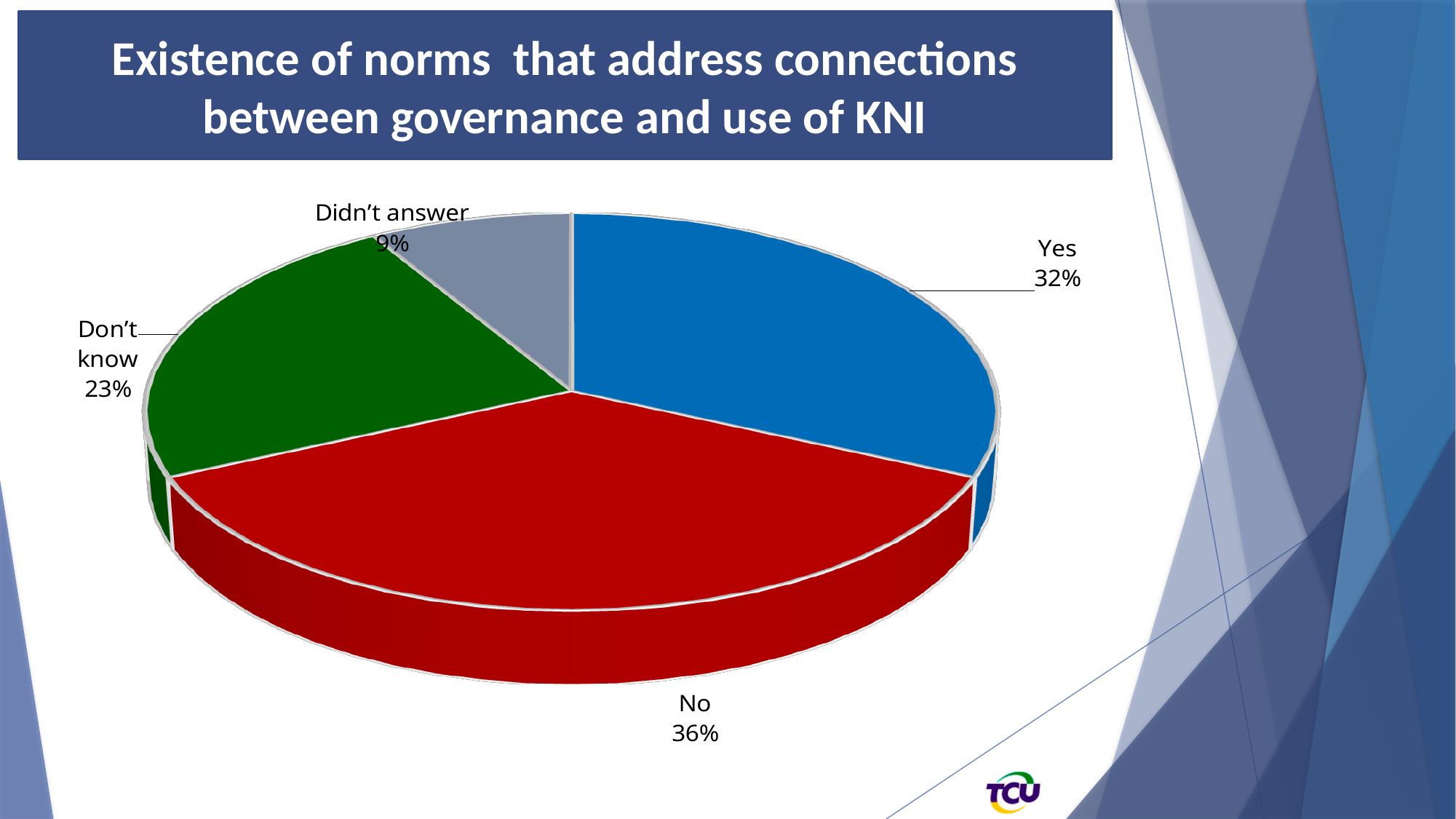
What kind of chart is shown on the slide? Pie chart How many slices does the pie chart have? 4 What is the combined share of "Yes" and "No" responses? 68% Which response has the largest share of the pie? No What percentage of respondents answered "No"? 36% Which is larger, the share for "Don't know" or the share for "Didn't answer"? Don't know What share of the pie is labelled "Don't know"? 23% What percentage is shown for "Didn't answer"? 9% What percentage of respondents answered "Yes"? 32% What is the difference in percentage points between "No" and "Yes"? 4 What colour is the "No" slice of the pie? Red Which response has the smallest share of the pie? Didn't answer